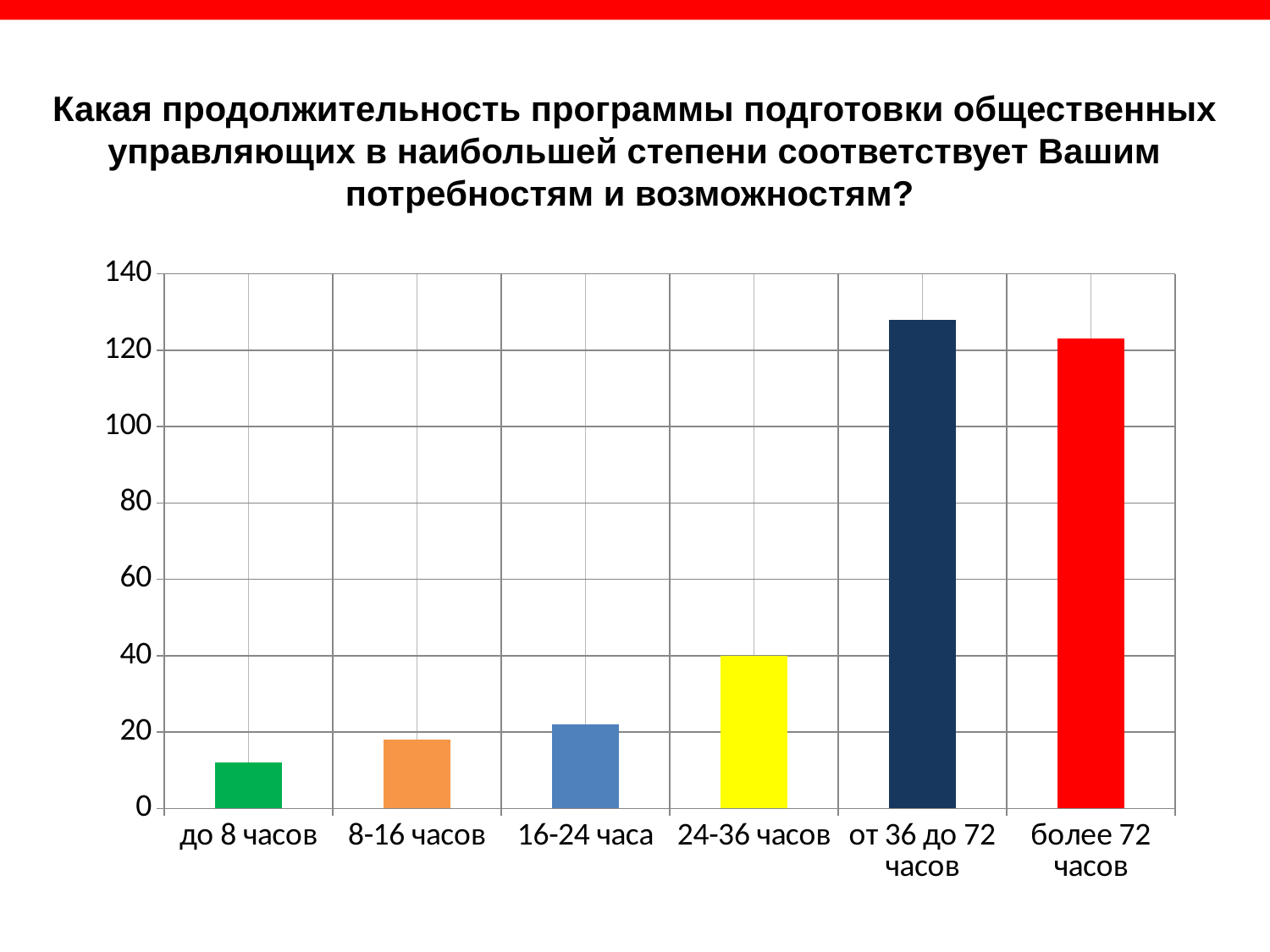
Is the value for "24-36 часов" greater or less than 60? less What colour is the bar for "более 72 часов"? red Do the values generally rise or fall from "до 8 часов" to "от 36 до 72 часов"? rise Is the value for "более 72 часов" greater or less than 100? greater Is the value for "до 8 часов" greater or less than 20? less Which category has the lowest bar? до 8 часов How many categories are shown on the x axis of the chart? 6 Which is larger, the value for "24-36 часов" or the value for "8-16 часов"? 24-36 часов What kind of chart is shown on the slide? bar chart Which category has the highest bar? от 36 до 72 часов